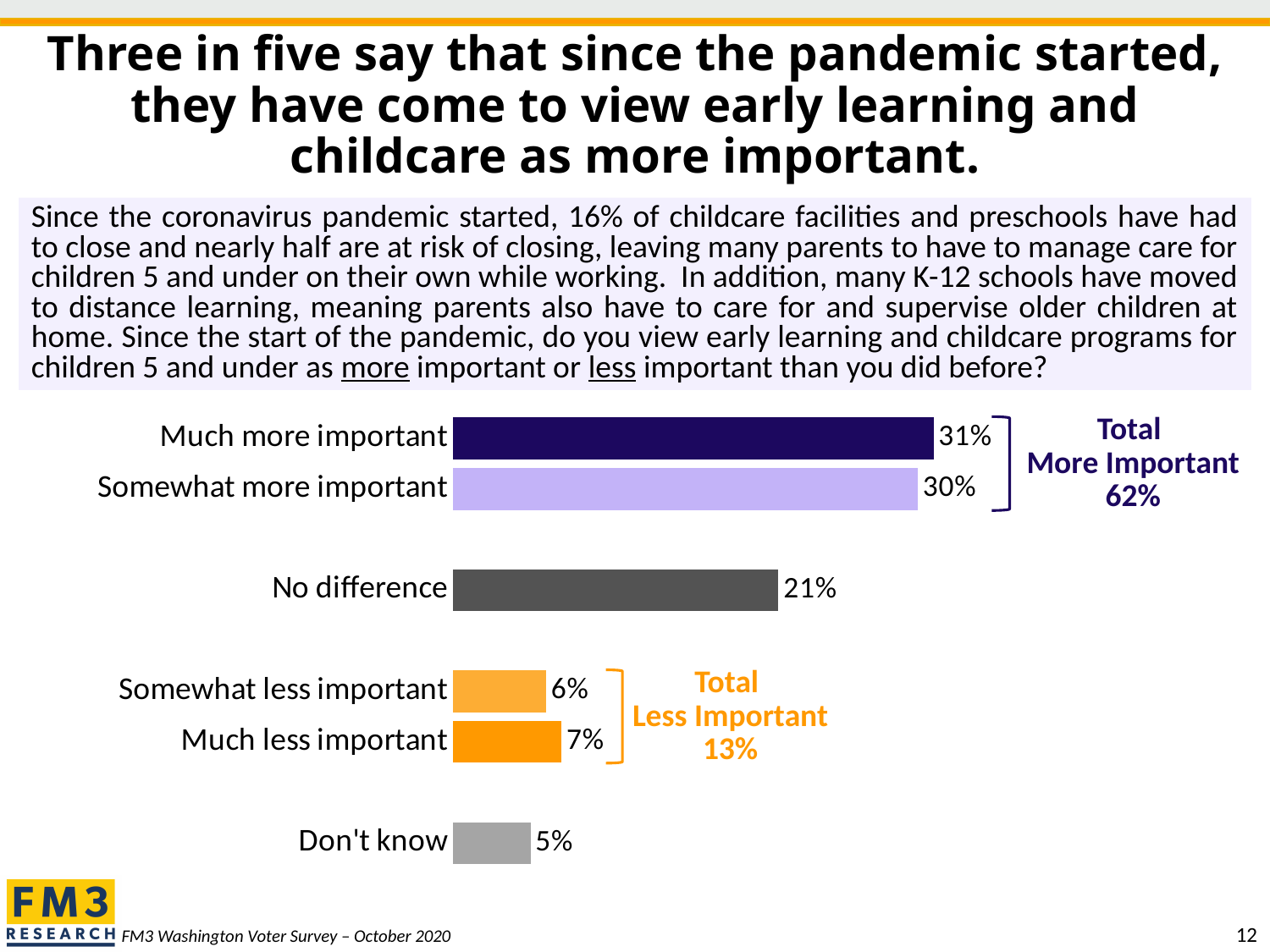
What type of chart is shown on the slide? Bar chart What is the 'Total More Important' percentage shown on the slide? 62% How many response categories are shown in the chart? 6 What percentage of respondents said early learning and childcare are much more important? 31% What percentage of respondents said 'Much less important'? 7% Which response category has the lowest percentage? Don't know What percentage of respondents said 'Somewhat more important'? 30% What percentage of respondents answered 'Don't know'? 5% Which is larger: 'Somewhat less important' or 'Much less important'? Much less important What percentage of respondents said 'No difference'? 21% Which response category has the highest percentage? Much more important What is the difference between the 'Much more important' and 'No difference' percentages? 10%